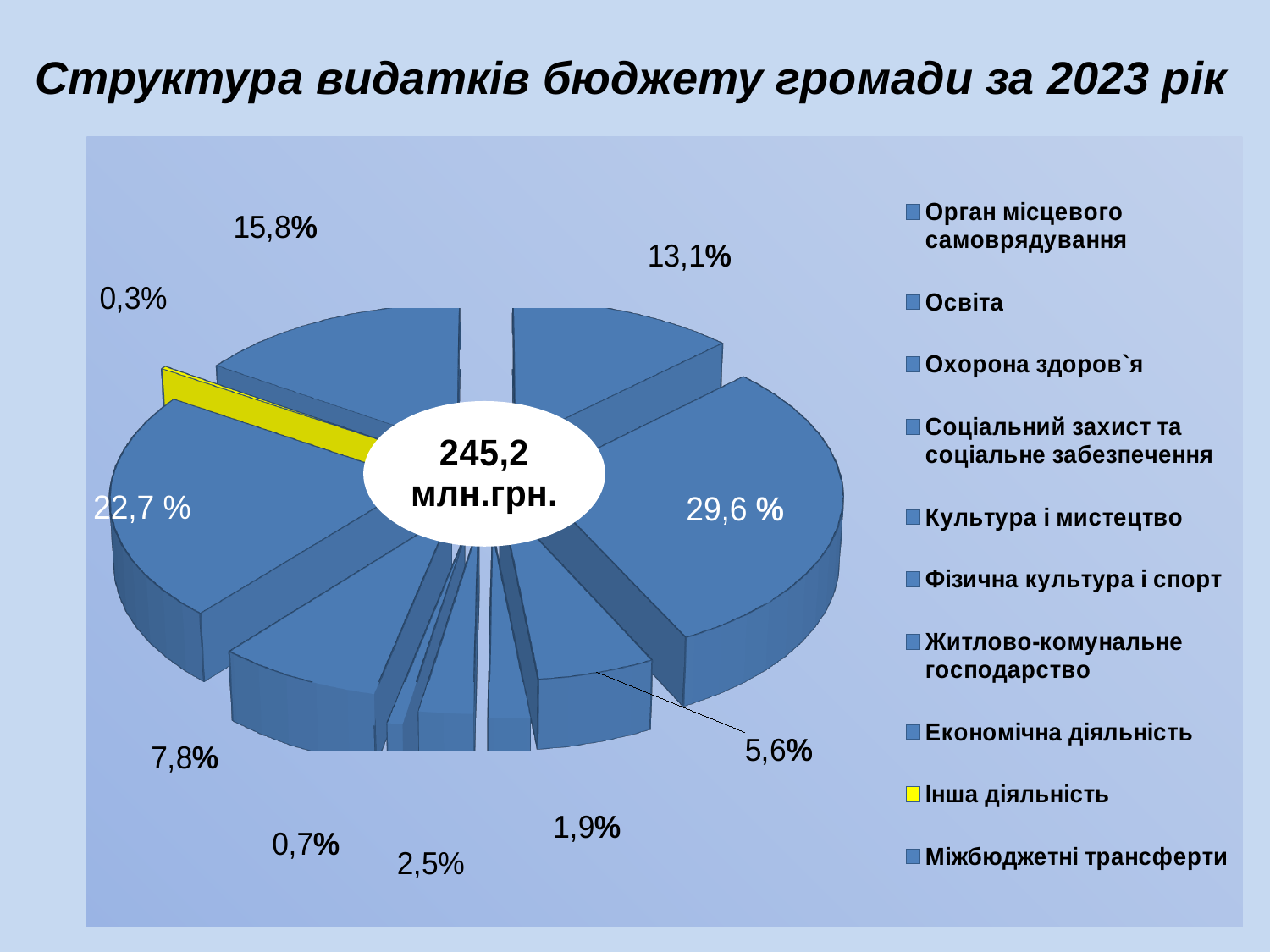
What total amount is printed in the centre of the pie chart? 245,2 млн.грн. Which is larger on the pie chart: the slice labelled 15,8% or the slice labelled 13,1%? 15,8% What is the difference between the largest slice (29,6 %) and the second largest slice (22,7 %)? 6,9 % Which legend category is shown in yellow on the pie chart? Інша діяльність What is the smallest percentage shown on the pie chart? 0,3% What is the largest percentage shown on the pie chart? 29,6 % How many categories does the legend of the pie chart list? 10 What kind of chart is shown on the slide? pie chart Which is larger on the pie chart: the slice labelled 7,8% or the slice labelled 5,6%? 7,8% What is the title of the chart on the slide? Структура видатків бюджету громади за 2023 рік How many percentage data labels are printed around the pie chart? 10 What share of the pie does the yellow slice (Інша діяльність) represent? 0,3%